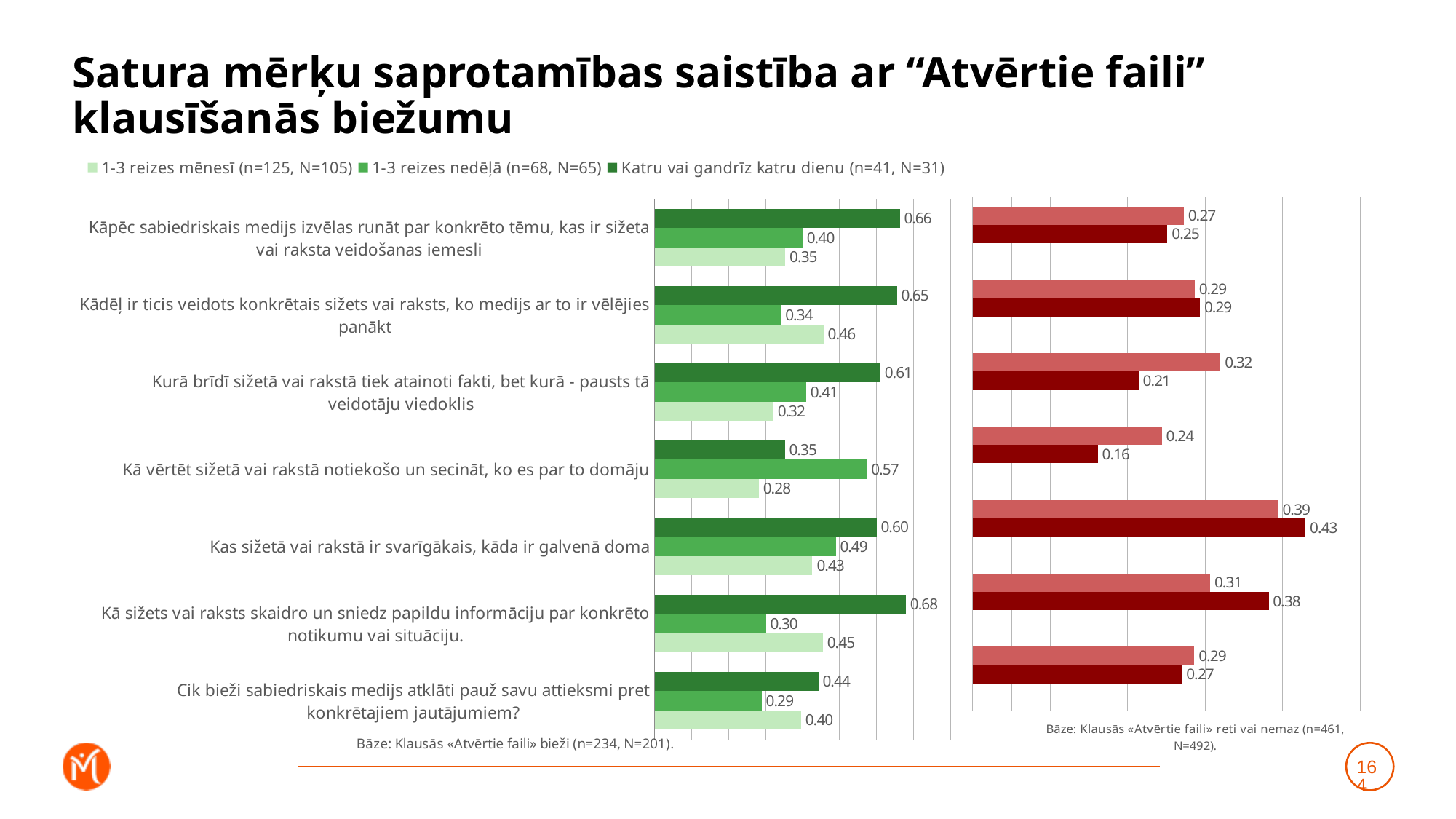
How many series does the legend of the green chart list? 3 What base note is printed below the left-hand green chart? Bāze: Klausās «Atvērtie faili» bieži (n=234, N=201). What kind of chart is the left-hand (green) chart on the slide? Bar chart In the green chart, what is the value for '1-3 reizes mēnesī' for the category 'Kādēļ ir ticis veidots konkrētais sižets vai raksts, ko medijs ar to ir vēlējies panākt'? 0.46 How many categories (statements) are plotted in the left-hand green chart? 7 In the green chart, which category has the lowest value for the series 'Katru vai gandrīz katru dienu'? Kā vērtēt sižetā vai rakstā notiekošo un secināt, ko es par to domāju In the green chart, for the category 'Kāpēc sabiedriskais medijs izvēlas runāt par konkrēto tēmu, kas ir sižeta vai raksta veidošanas iemesli', what is the difference between the 'Katru vai gandrīz katru dienu' value and the '1-3 reizes mēnesī' value? 0.31 In the green chart, which category has the highest value for the series 'Katru vai gandrīz katru dienu'? Kā sižets vai raksts skaidro un sniedz papildu informāciju par konkrēto notikumu vai situāciju. In the right-hand (red) chart, what is the highest value shown? 0.43 In the right-hand (red) chart, what is the lowest value shown? 0.16 In the green chart, for the category 'Kā vērtēt sižetā vai rakstā notiekošo un secināt, ko es par to domāju', which series has the larger value: '1-3 reizes nedēļā' or 'Katru vai gandrīz katru dienu'? 1-3 reizes nedēļā In the green chart, what is the value for 'Katru vai gandrīz katru dienu' for the category 'Kas sižetā vai rakstā ir svarīgākais, kāda ir galvenā doma'? 0.60